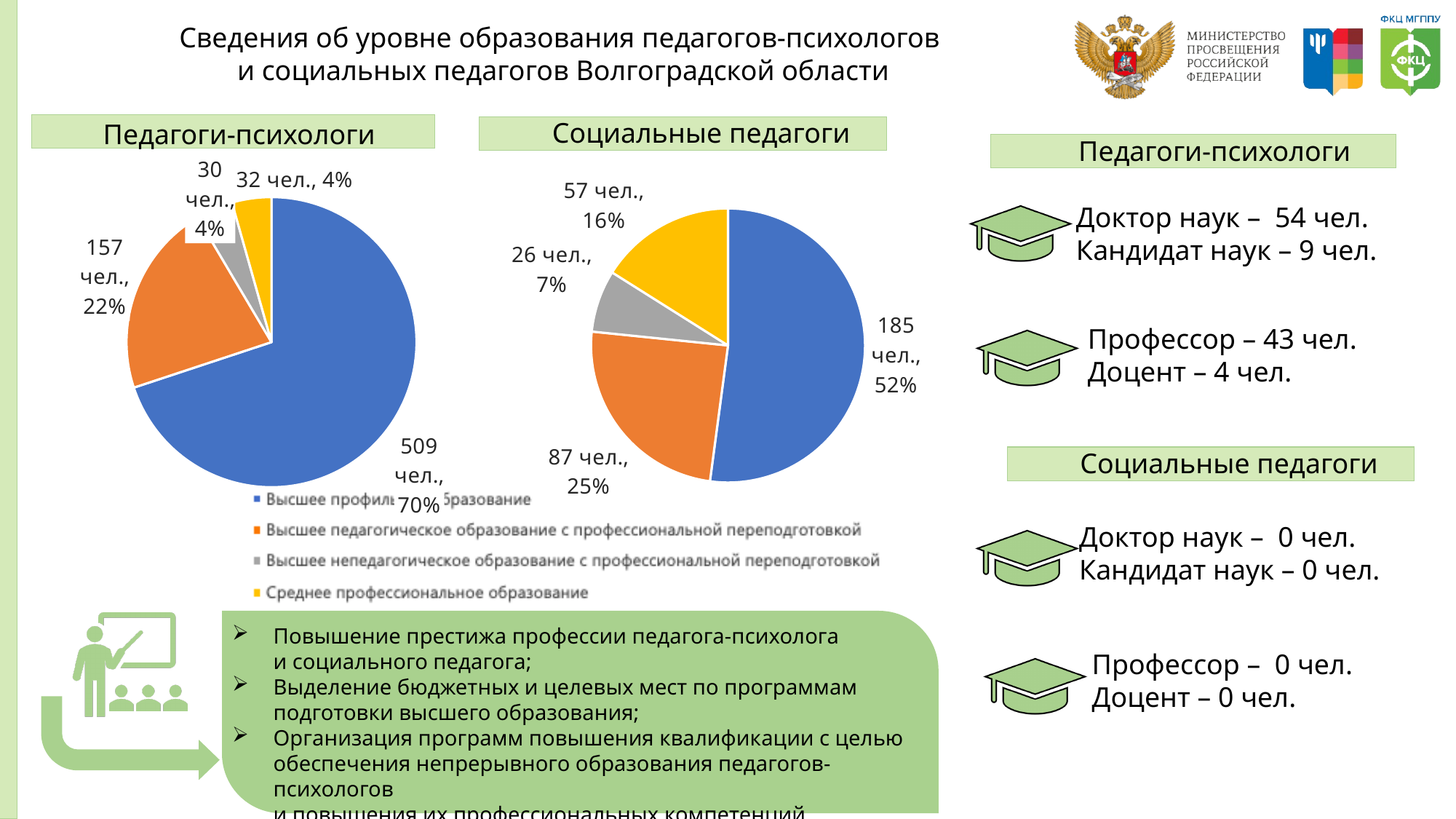
In the «Социальные педагоги» pie chart, what share does the gray slice (Высшее непедагогическое образование с профессиональной переподготовкой) have? 7% In the «Педагоги-психологи» pie chart, which is larger: the orange slice or the yellow slice? the orange slice In the «Социальные педагоги» pie chart, what is the difference in people between the orange slice (87 чел.) and the yellow slice (57 чел.)? 30 чел. In the «Социальные педагоги» pie chart, which category is the smallest? Высшее непедагогическое образование с профессиональной переподготовкой In the «Педагоги-психологи» pie chart, what share does the largest slice have? 70% What kind of chart is used under the heading «Педагоги-психологи»? pie chart How many slices does the «Социальные педагоги» pie chart have? 4 In the «Социальные педагоги» pie chart, what is the value of the yellow slice (Среднее профессиональное образование)? 57 чел., 16% In the «Педагоги-психологи» pie chart, how many people are in the largest slice? 509 чел. How many entries does the shared legend below the pie charts list? 4 In the «Социальные педагоги» pie chart, which slice is the largest? Высшее профильное образование (185 чел., 52%) In the «Педагоги-психологи» pie chart, what is the value of the orange slice (Высшее педагогическое образование с профессиональной переподготовкой)? 157 чел., 22%